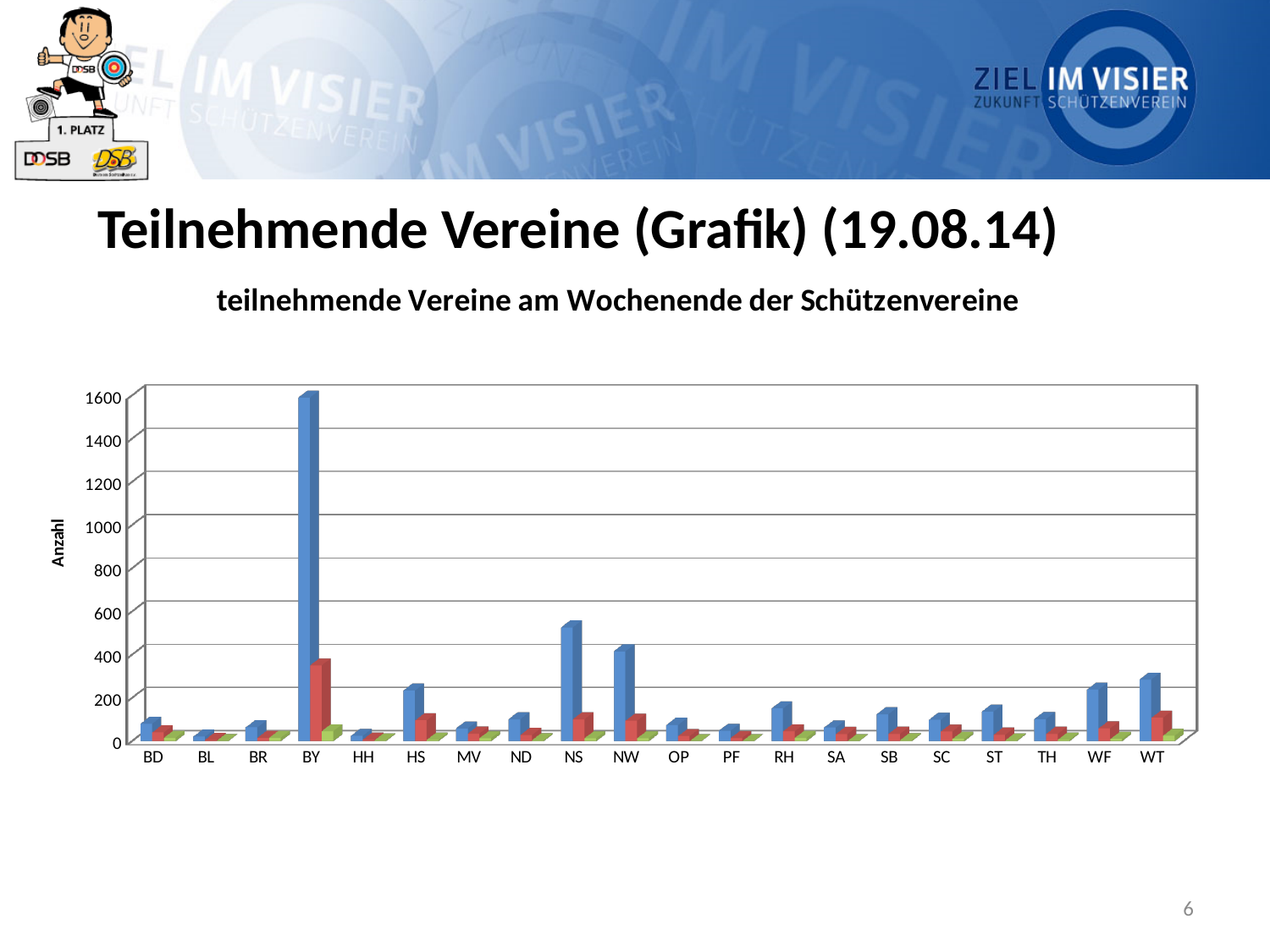
What kind of chart is shown on the slide? bar chart What is the label on the vertical axis of the chart? Anzahl Which category has the tallest bar in the chart? BY How many categories are shown along the x axis of the chart? 20 Which has the larger blue bar, BY or NS? BY Is the value of the blue bar for WT greater or less than 400? less What is the title of the chart? teilnehmende Vereine am Wochenende der Schützenvereine Is the value of the red bar for BY greater or less than 200? greater Is the value of the blue bar for NS greater or less than 400? greater Which has the larger blue bar, NS or NW? NS